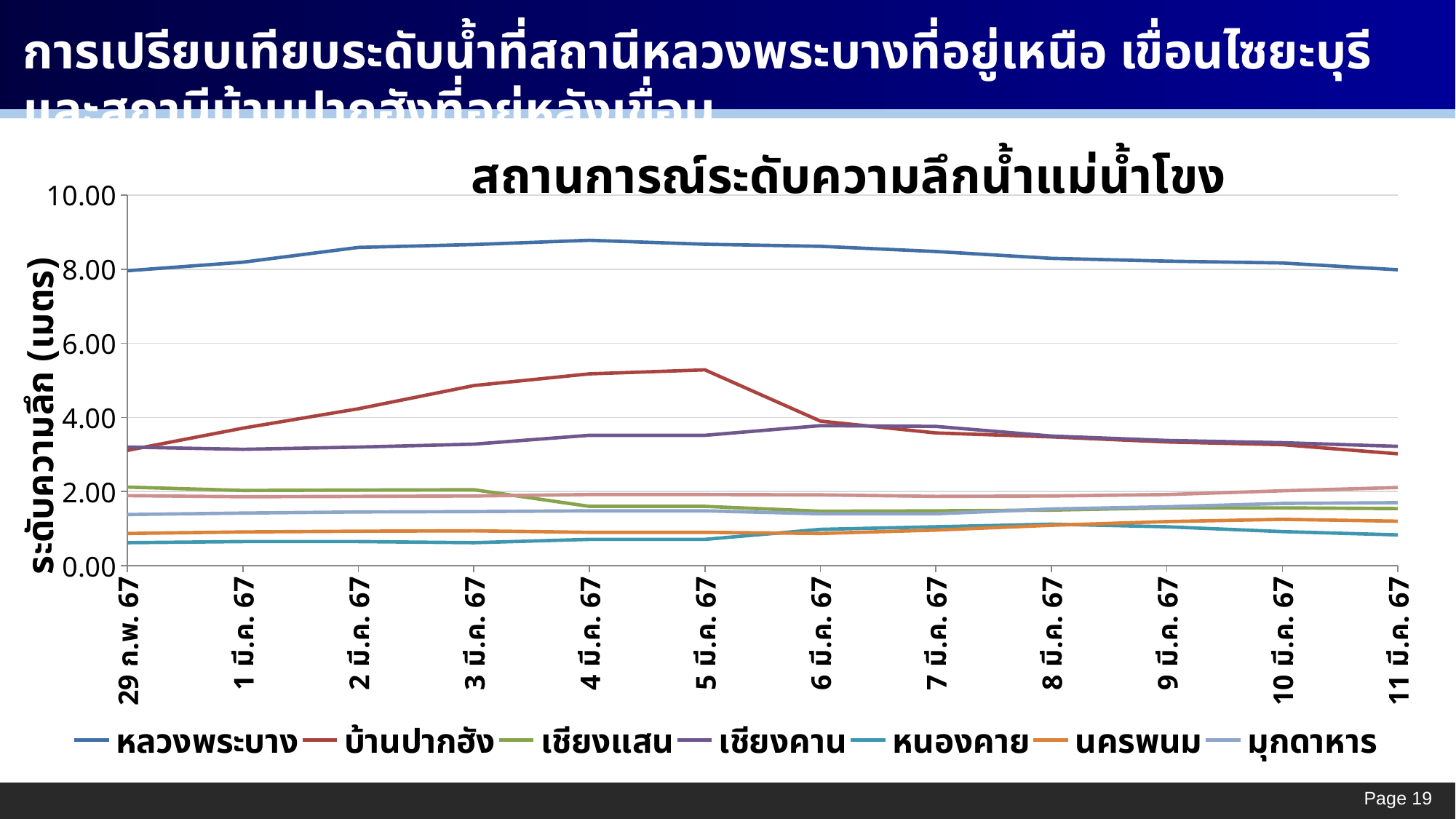
What kind of chart is shown on the slide? line chart What is the label of the y axis? ระดับความลึก (เมตร) Is the value for หลวงพระบาง on 4 มี.ค. 67 greater or less than 8.00? greater On 5 มี.ค. 67, which is larger: บ้านปากฮัง or เชียงคาน? บ้านปากฮัง Is the value for บ้านปากฮัง on 5 มี.ค. 67 greater or less than 4.00? greater How many dates are shown along the x axis? 12 Which series has the lowest value on 29 ก.พ. 67? หนองคาย Which series has the highest values across the whole chart? หลวงพระบาง How many series does the legend list? 7 Does the value for บ้านปากฮัง rise or fall from 29 ก.พ. 67 to 5 มี.ค. 67? rise What is the title of the chart? สถานการณ์ระดับความลึกน้ำแม่น้ำโขง Is the value for เชียงคาน on 29 ก.พ. 67 greater or less than 4.00? less